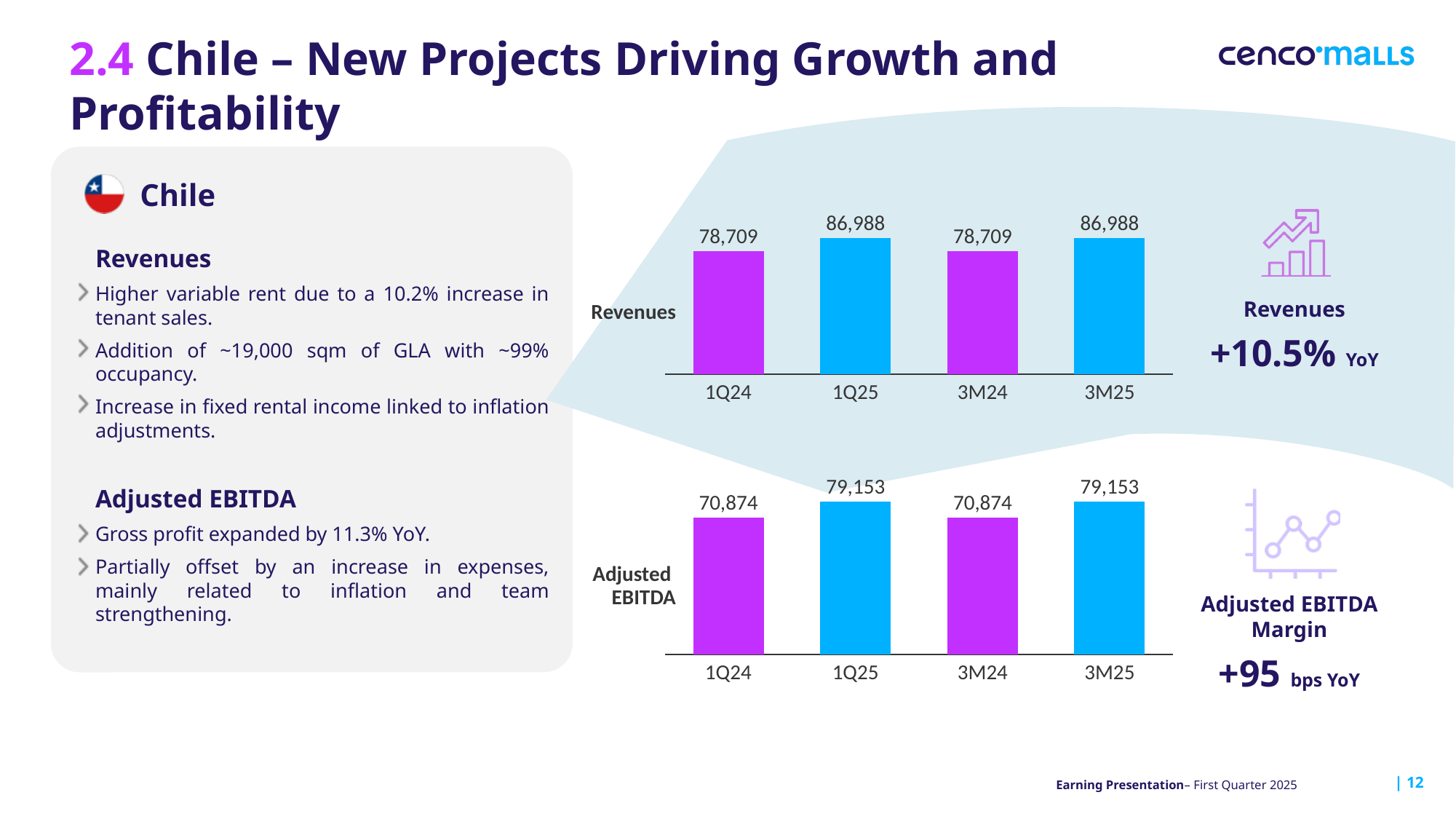
In the Adjusted EBITDA chart, what is the value for 3M24? 70,874 In the Revenues chart, what colour are the 1Q25 and 3M25 bars? Blue In the Adjusted EBITDA chart, which is larger, the value for 3M24 or the value for 3M25? 3M25 In the Adjusted EBITDA chart, what is the value for 3M25? 79,153 In the Revenues chart, which is larger, the value for 1Q24 or the value for 1Q25? 1Q25 In the Revenues chart, what is the difference between the 1Q25 and 1Q24 values? 8,279 In the Revenues chart, what is the value for 1Q24? 78,709 How many bars are shown in the Revenues chart? 4 What type of chart is the Adjusted EBITDA chart? Bar chart In the Adjusted EBITDA chart, what is the difference between the 3M25 and 3M24 values? 8,279 In the Revenues chart, what is the value for 1Q25? 86,988 How many bars are shown in the Adjusted EBITDA chart? 4